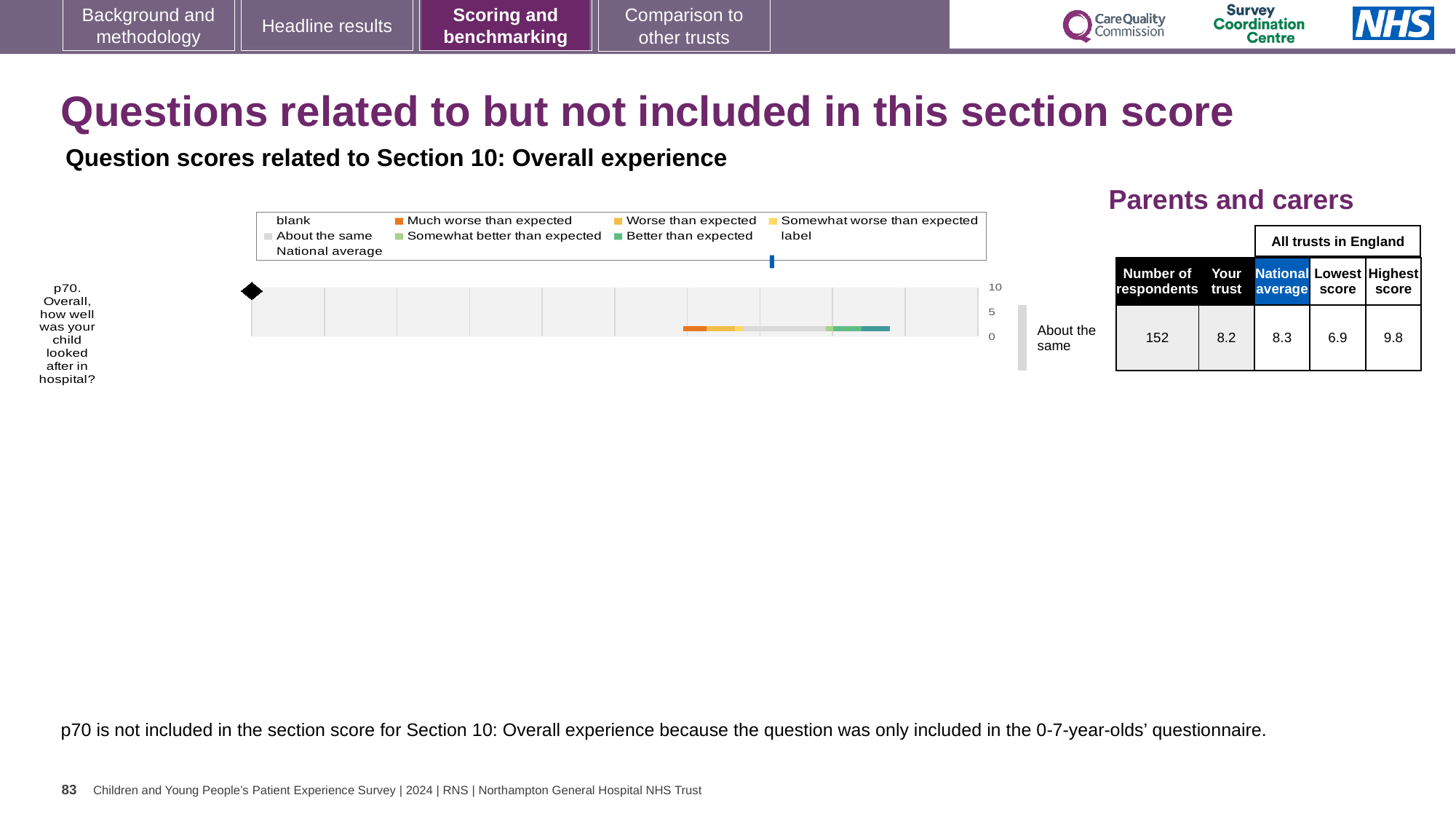
What is the 'Your trust' score for p70 in the Parents and carers table? 8.2 What is the national average score for p70? 8.3 What is the highest score among all trusts in England for p70? 9.8 Which is larger for p70, the 'Your trust' score or the national average? National average How many questions are plotted in the chart? 1 How many respondents answered p70? 152 What is the difference between the highest and lowest trust scores for p70? 2.9 What kind of chart is shown for question p70? bar chart What is the lowest score among all trusts in England for p70? 6.9 What is the highest value shown on the chart's axis? 10 Which question text is shown as the category label on the chart? p70. Overall, how well was your child looked after in hospital? What comparison category is labelled next to the bar for p70? About the same